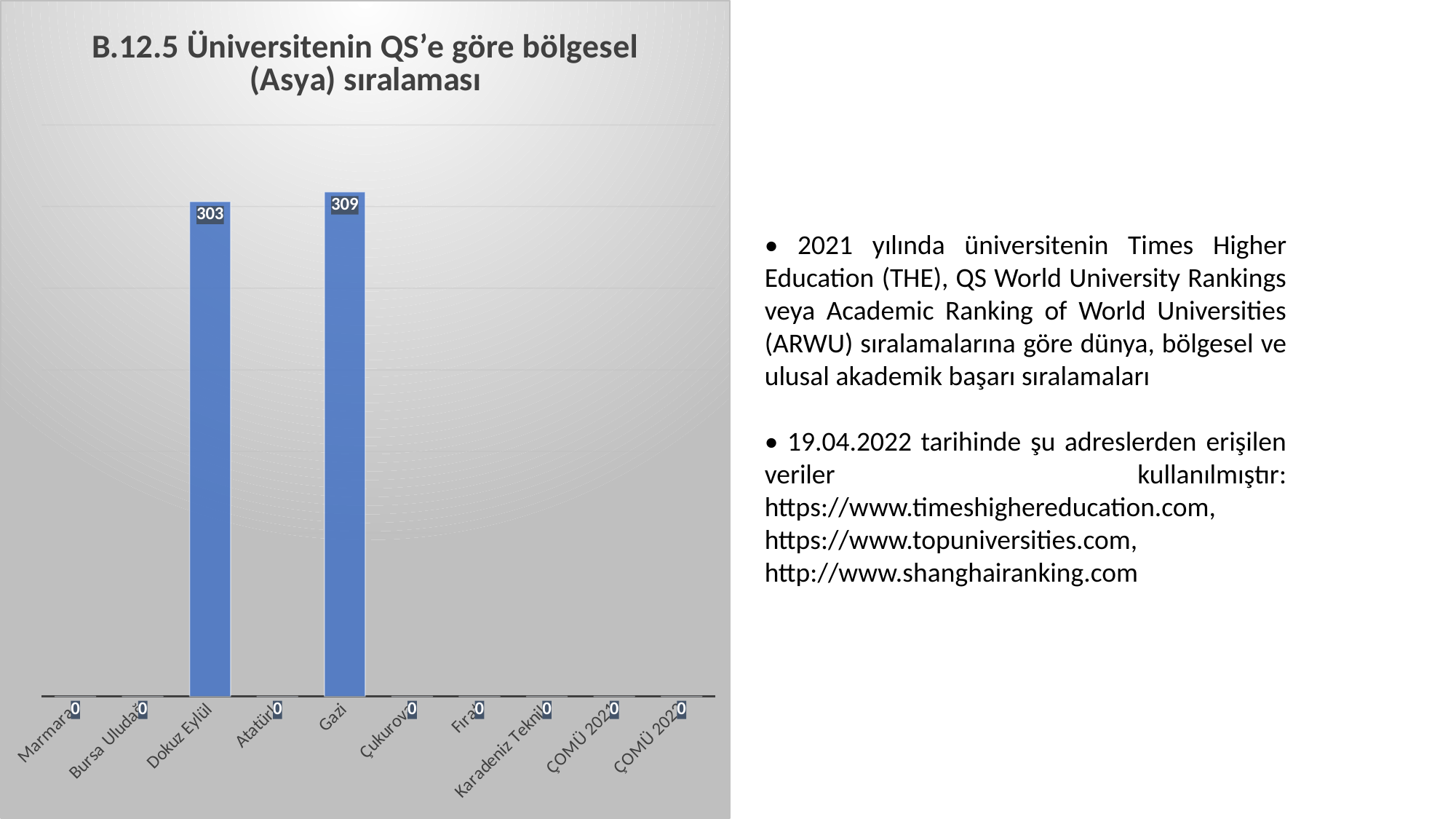
How many categories have a value of 0? 8 Which is larger, the value for Dokuz Eylül or the value for Gazi? Gazi What is the value for Gazi? 309 How many categories are shown on the x axis? 10 What is the title of the chart? B.12.5 Üniversitenin QS'e göre bölgesel (Asya) sıralaması What is the value for Karadeniz Teknik? 0 What is the value for Dokuz Eylül? 303 Which category has the highest value? Gazi What is the difference between the values for Gazi and Dokuz Eylül? 6 What is the value for ÇOMÜ 2021? 0 What kind of chart is shown on the slide? Bar chart What is the value for Marmara? 0